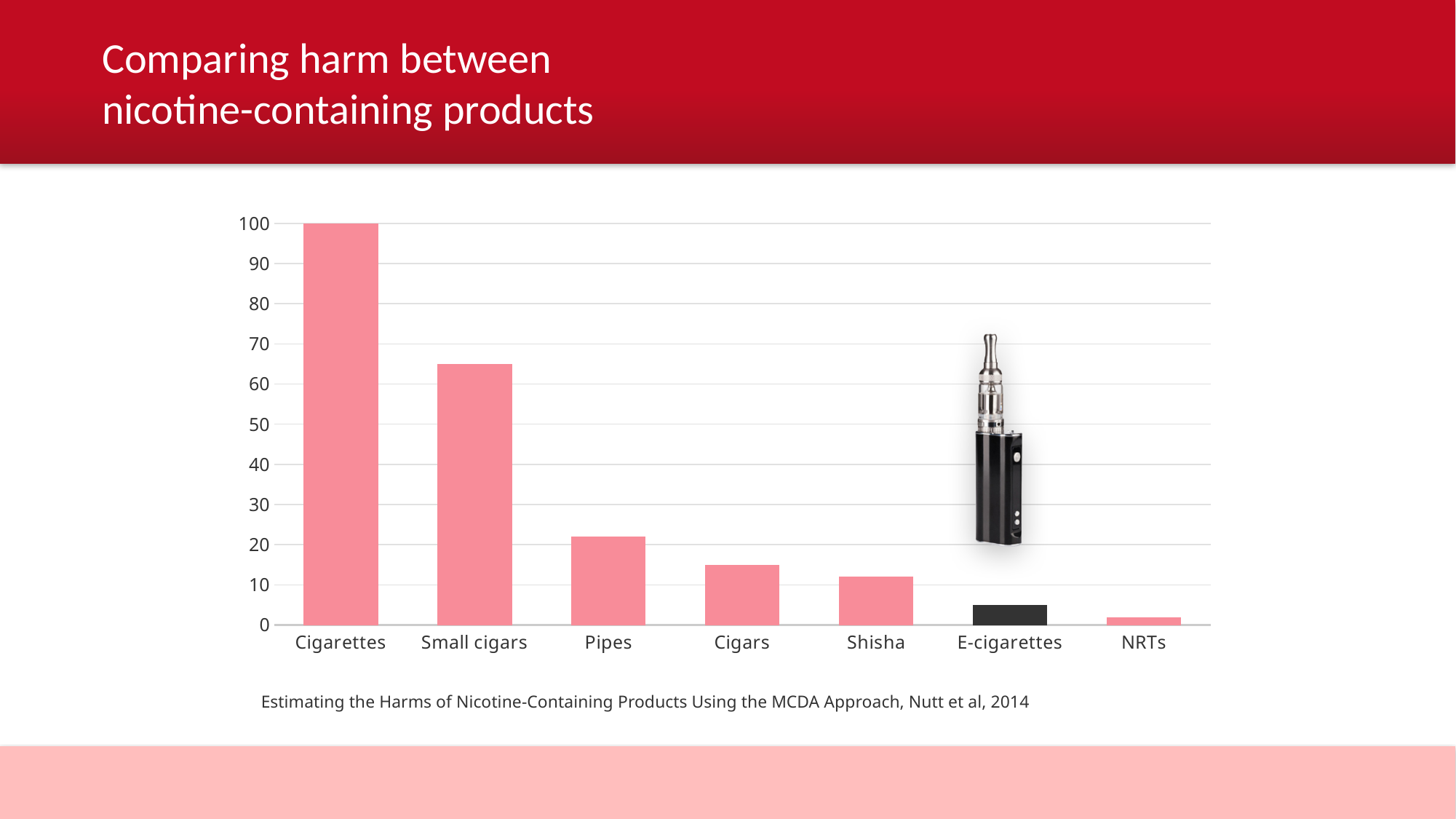
How many product categories are shown on the x axis? 7 Is the value for Cigars greater or less than 20? less Do the values rise or fall moving from left to right along the x axis? fall Which has a larger value, Pipes or Shisha? Pipes Is the value for Pipes greater or less than 30? less Is the value for E-cigarettes greater or less than 10? less What is the value for Cigarettes? 100 Which category's bar is drawn in a different (dark) colour from the others? E-cigarettes What type of chart is shown on the slide? bar chart Which product has the lowest harm value? NRTs Which product has the highest harm value? Cigarettes